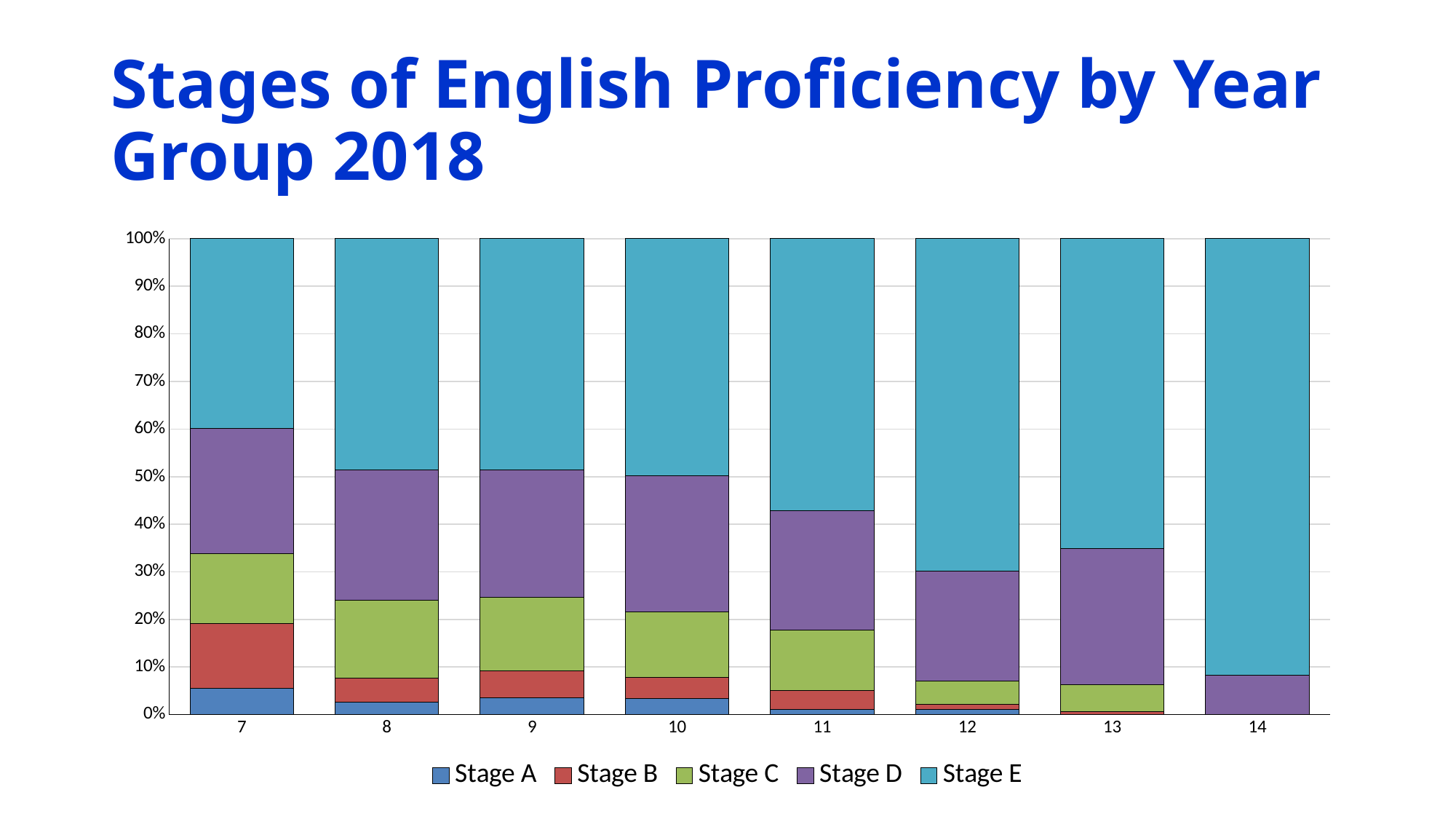
What does each stacked bar total? 100% What is the title of the chart? Stages of English Proficiency by Year Group 2018 How many series does the legend list? 5 Which is larger, the Stage D share for year group 7 or for year group 14? Year group 7 How many year groups are shown on the x axis? 8 Does the Stage E share generally rise or fall from year group 7 to year group 14? Rise Which year group has the largest Stage E share? 14 Which year group has the smallest Stage E share? 7 What kind of chart is shown on the slide? Stacked bar chart Which year group has the largest Stage B share? 7 Is the Stage E share for year group 14 greater or less than 80%? greater Is the Stage E share for year group 7 greater or less than 50%? less